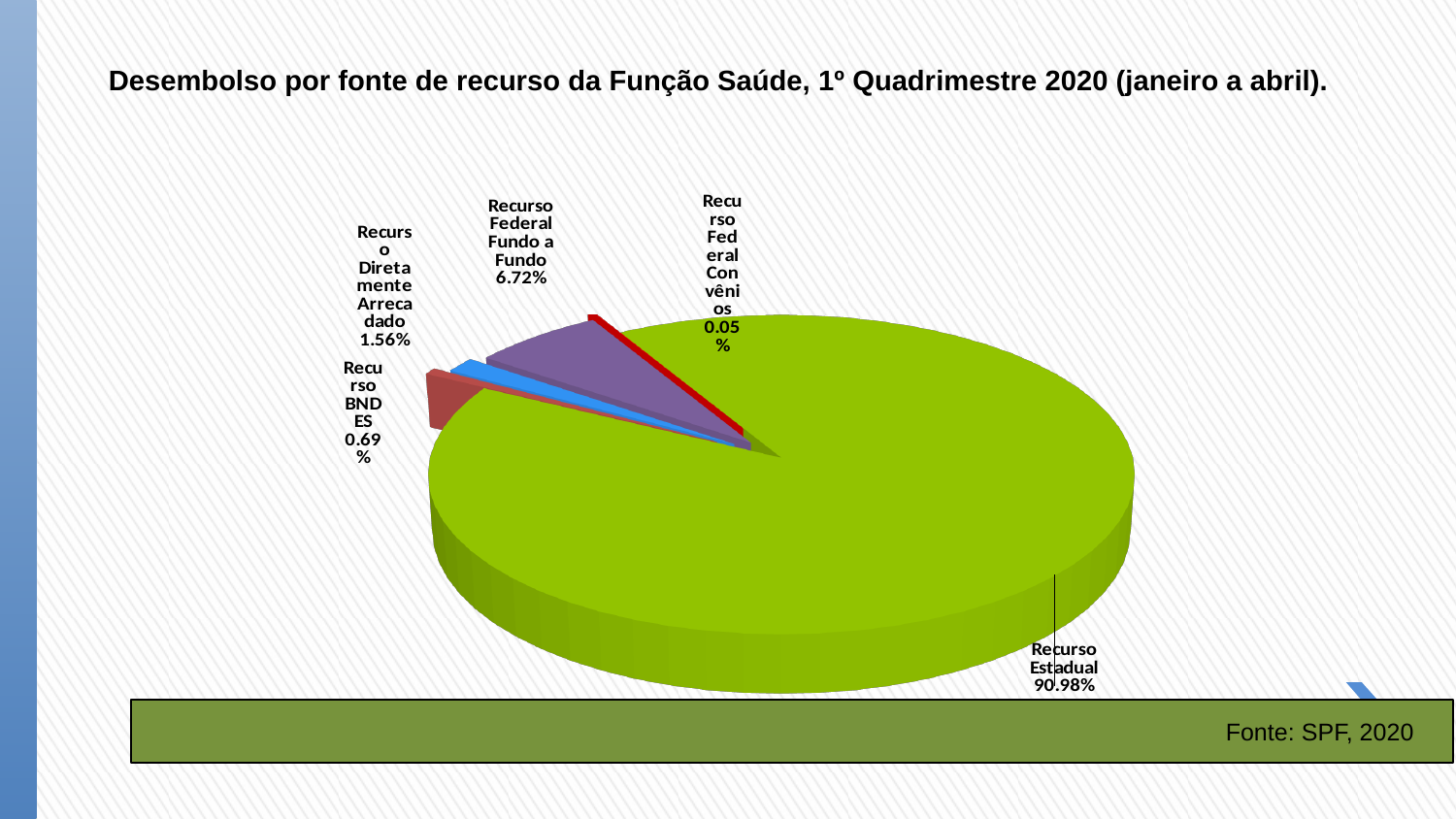
What is the difference in percentage points between Recurso Estadual and Recurso Federal Fundo a Fundo? 84.26% Which source of funds has the smallest share of the pie? Recurso Federal Convênios Which is larger, the share for Recurso Diretamente Arrecadado or the share for Recurso BNDES? Recurso Diretamente Arrecadado What source is cited below the chart? Fonte: SPF, 2020 What is the value shown for Recurso Federal Convênios? 0.05% What kind of chart is shown on the slide? Pie chart What is the value shown for Recurso Federal Fundo a Fundo? 6.72% What share of the pie does Recurso Estadual represent? 90.98% How many slices does the pie chart have? 5 Which source of funds has the largest share of the pie? Recurso Estadual What is the value shown for Recurso BNDES? 0.69% What is the value shown for Recurso Diretamente Arrecadado? 1.56%